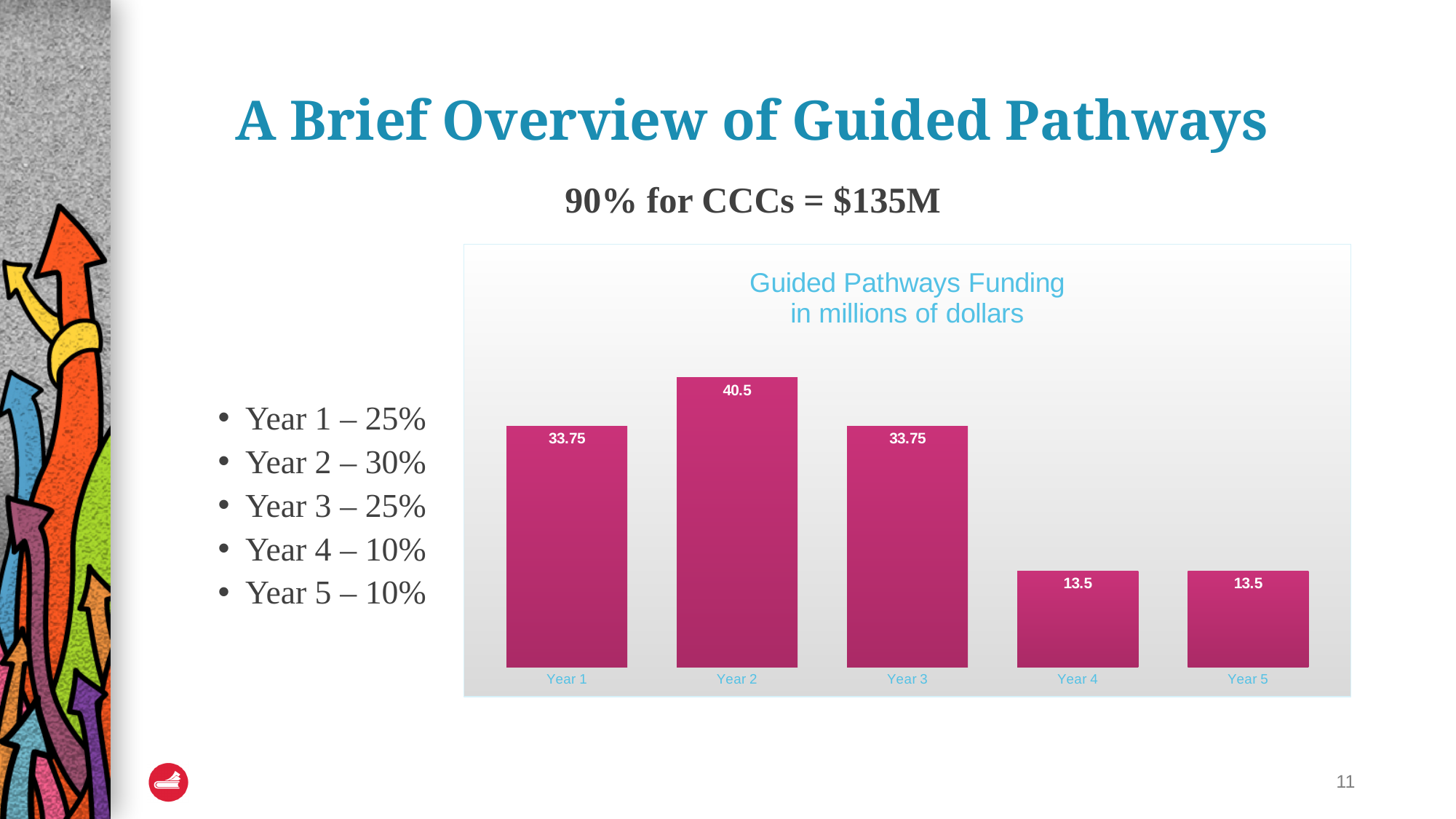
What is the title of the chart on the slide? Guided Pathways Funding in millions of dollars What is the value for Year 4 in the Guided Pathways Funding chart? 13.5 What is the value for Year 2 in the Guided Pathways Funding chart? 40.5 How many years are shown on the x axis of the Guided Pathways Funding chart? 5 What is the difference between the Year 2 and Year 3 values in the Guided Pathways Funding chart? 6.75 What is the value for Year 1 in the Guided Pathways Funding chart? 33.75 Do the values in the Guided Pathways Funding chart rise or fall from Year 3 to Year 4? Fall What is the difference between the Year 1 and Year 4 values in the Guided Pathways Funding chart? 20.25 What kind of chart is the Guided Pathways Funding chart? Bar chart What is the total of the Year 4 and Year 5 values in the Guided Pathways Funding chart? 27 Which is larger in the Guided Pathways Funding chart, Year 2 or Year 5? Year 2 Which year has the highest funding in the Guided Pathways Funding chart? Year 2